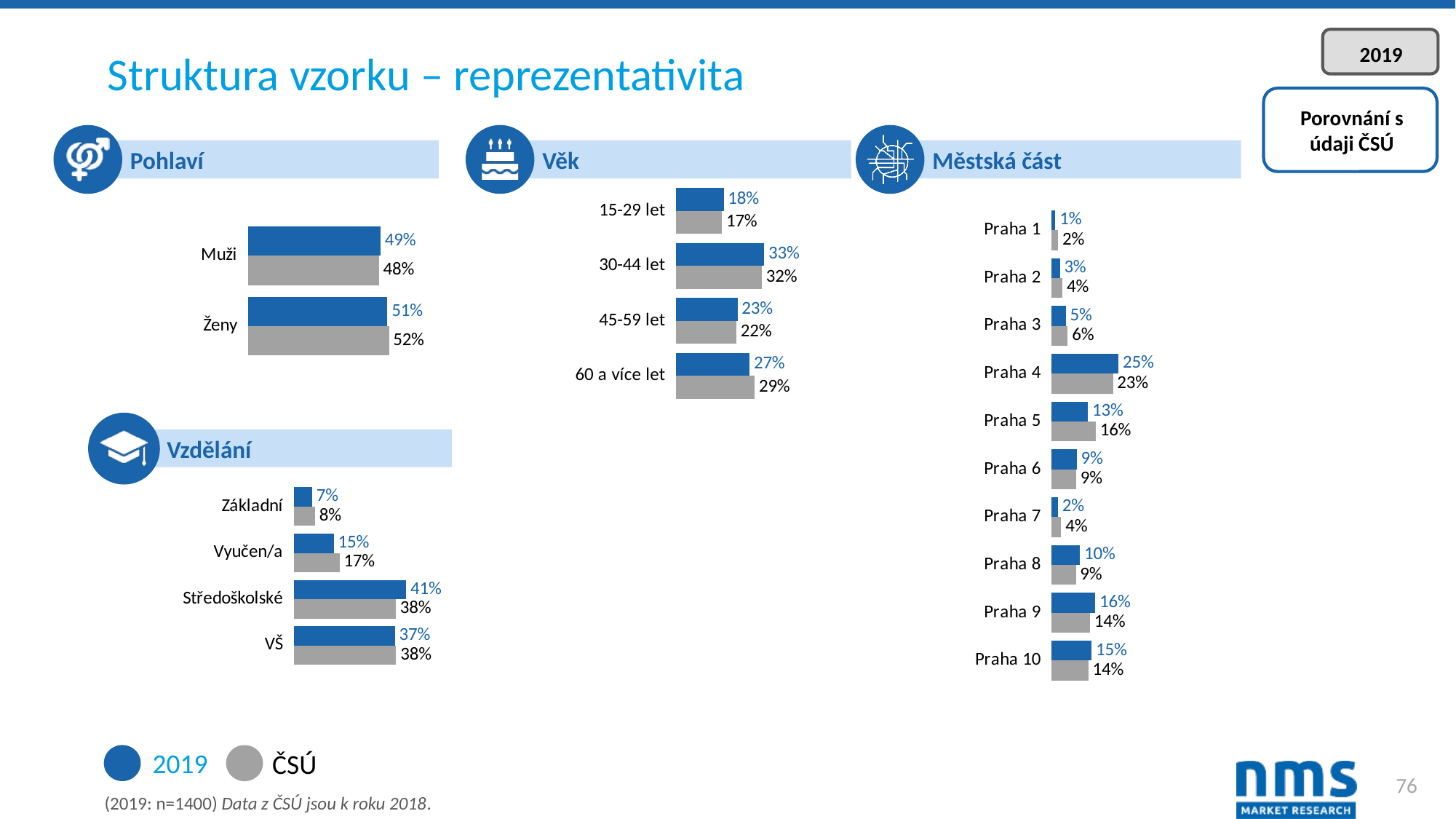
In the Městská část chart, how many districts are listed? 10 In the Pohlaví chart, what is the 2019 value for Ženy? 51% In the Městská část chart, which district has the highest 2019 value? Praha 4 In the Věk chart, which age group has the highest 2019 value? 30-44 let In the Pohlaví chart, what is the ČSÚ value for Muži? 48% In the Vzdělání chart, which is larger: the 2019 value for Středoškolské or the 2019 value for VŠ? Středoškolské In the Věk chart, what is the difference between the 2019 and ČSÚ values for 60 a více let? 2% In the Věk chart, how many age categories are shown? 4 In the Vzdělání chart, what is the ČSÚ value for Vyučen/a? 17% How many series does the legend at the bottom of the slide list? 2 In the Městská část chart, what is the ČSÚ value for Praha 5? 16% In the Městská část chart, which district has the lowest 2019 value? Praha 1